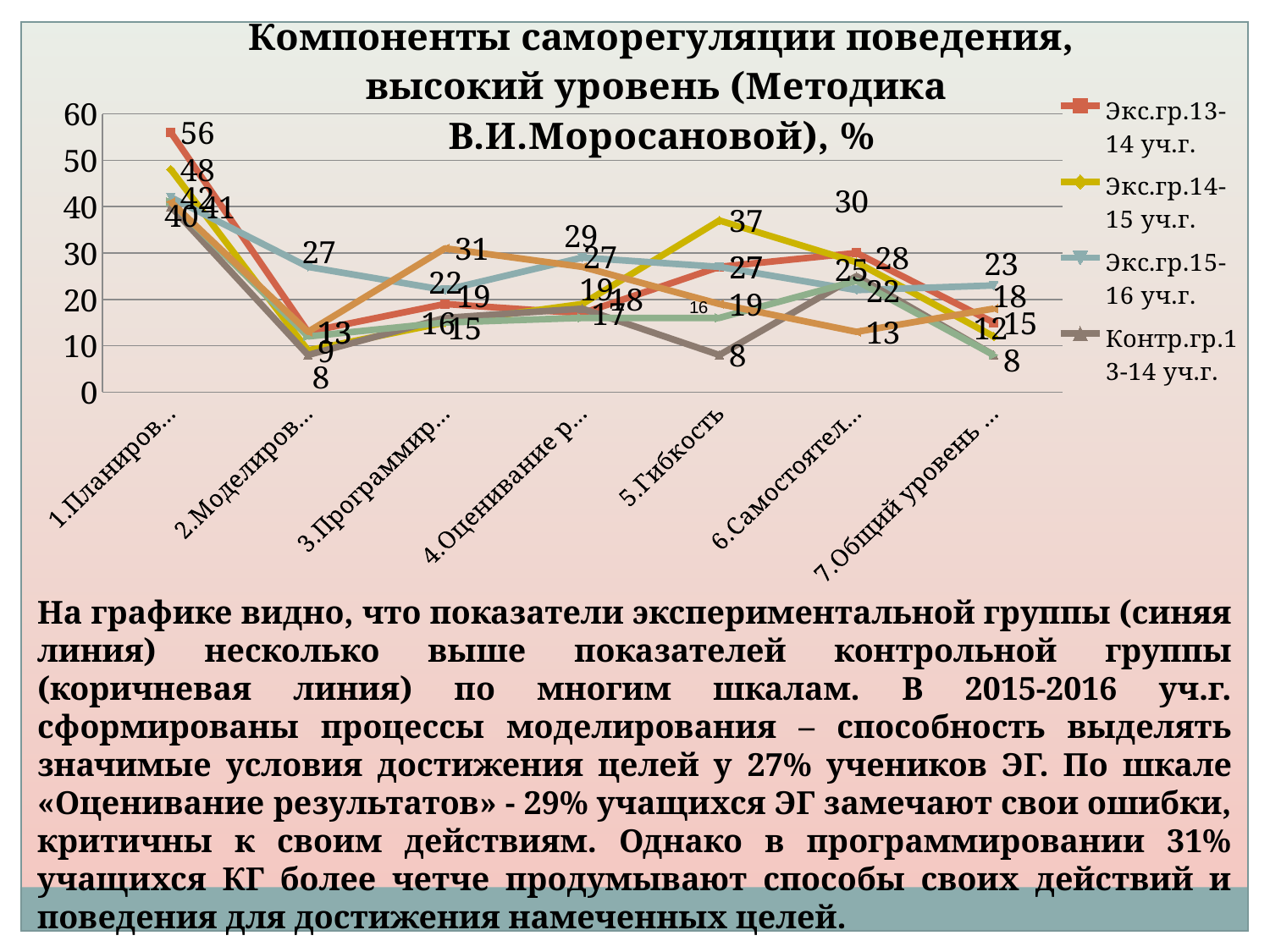
Is the value for Экс.гр.14-15 уч.г. at 5.Гибкость greater or less than 30? greater In which category does Экс.гр.14-15 уч.г. reach its highest value? 1.Планиров... What is the value for Экс.гр.14-15 уч.г. at 5.Гибкость? 37 What is the difference between Экс.гр.13-14 уч.г. and Экс.гр.14-15 уч.г. at 1.Планиров...? 8 At 5.Гибкость, which is larger: Экс.гр.14-15 уч.г. or Контр.гр.13-14 уч.г.? Экс.гр.14-15 уч.г. What is the value for Контр.гр.13-14 уч.г. at 5.Гибкость? 8 What is the value for Экс.гр.13-14 уч.г. at 6.Самостоятел...? 30 What is the highest value plotted on the chart? 56 What kind of chart is shown on the slide? line chart How many categories are shown along the x axis of the chart? 7 What is the value for Экс.гр.15-16 уч.г. at 7.Общий уровень ...? 23 What is the value for Экс.гр.13-14 уч.г. at 1.Планиров...? 56